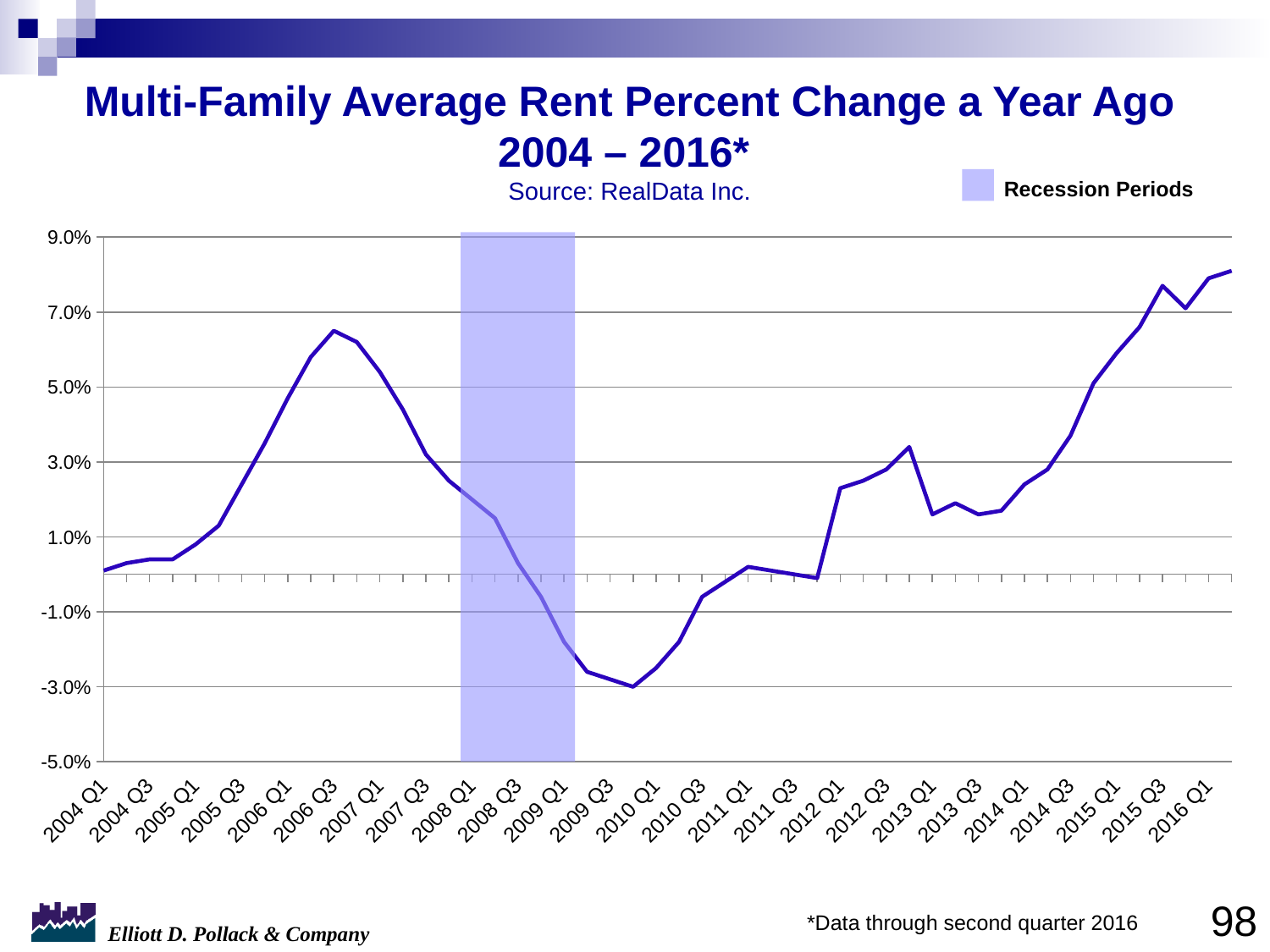
What kind of chart is shown on the slide? Line chart Is the value for 2015 Q3 greater or less than 7.0%? greater Is the value for 2006 Q3 greater or less than 5.0%? greater What does the shaded area in the chart represent, according to the legend? Recession Periods Do the values rise or fall from 2006 Q3 to 2010 Q1? fall Is the value for 2009 Q3 greater or less than -1.0%? less Which is larger, the value for 2006 Q3 or the value for 2012 Q1? 2006 Q3 Do the values rise or fall from 2013 Q3 to 2016 Q1? rise What is the title of the chart? Multi-Family Average Rent Percent Change a Year Ago 2004 – 2016*